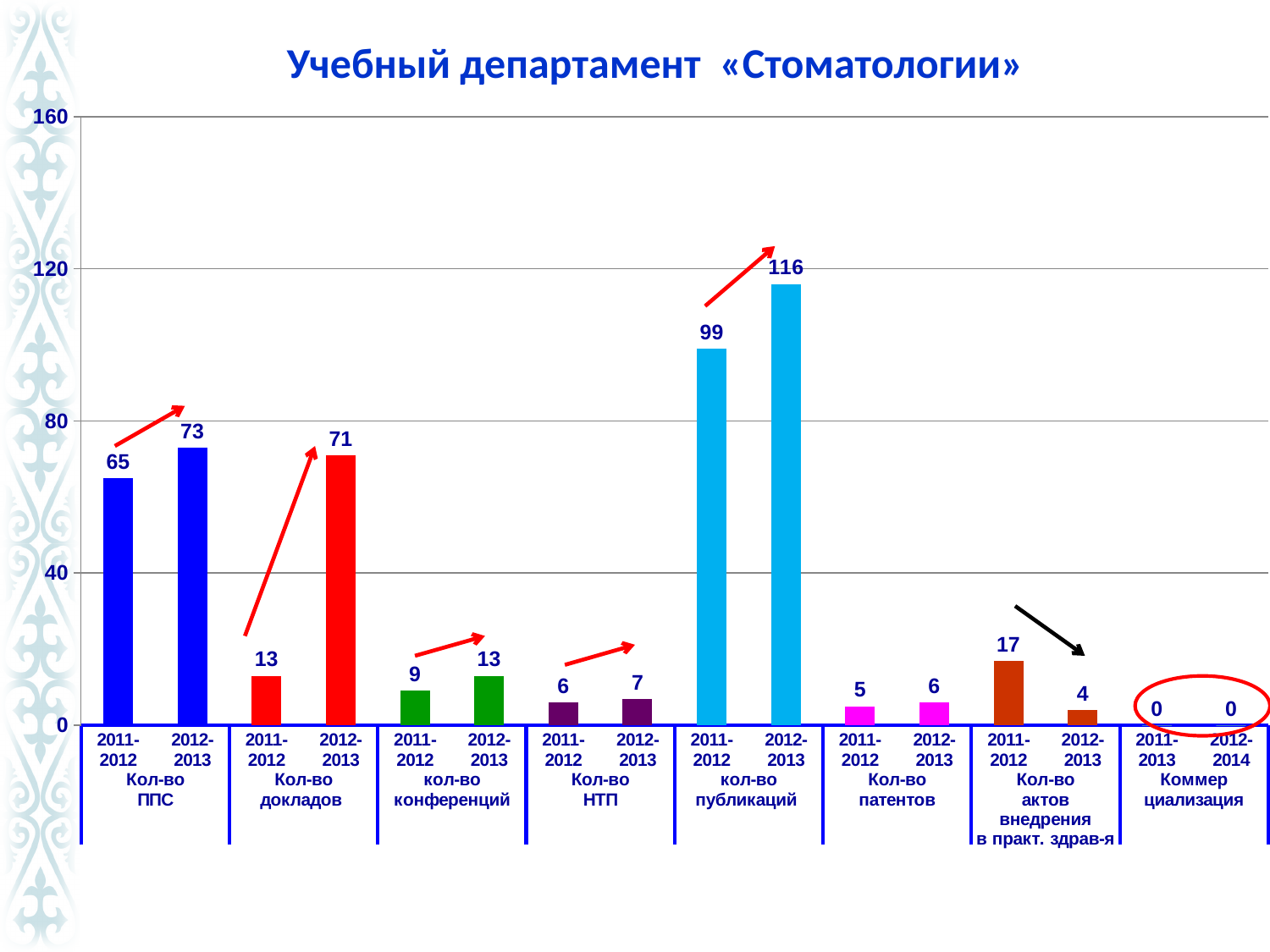
What is the title of the slide? Учебный департамент «Стоматологии» What is the value for кол-во публикаций in 2011-2012? 99 Which is larger for Кол-во актов внедрения в практ. здрав-я: the 2011-2012 value or the 2012-2013 value? 2011-2012 How many category groups are shown on the chart? 8 Which bar has the highest value on the chart? кол-во публикаций, 2012-2013 Which category has the lowest values on the chart? Коммерциализация What is the difference between the 2012-2013 and 2011-2012 values for кол-во публикаций? 17 What is the value for Кол-во актов внедрения в практ. здрав-я in 2012-2013? 4 What is the difference between the 2012-2013 and 2011-2012 values for Кол-во докладов? 58 What is the value for Кол-во ППС in 2012-2013? 73 What is the value for Кол-во докладов in 2012-2013? 71 What kind of chart is shown on the slide? bar chart